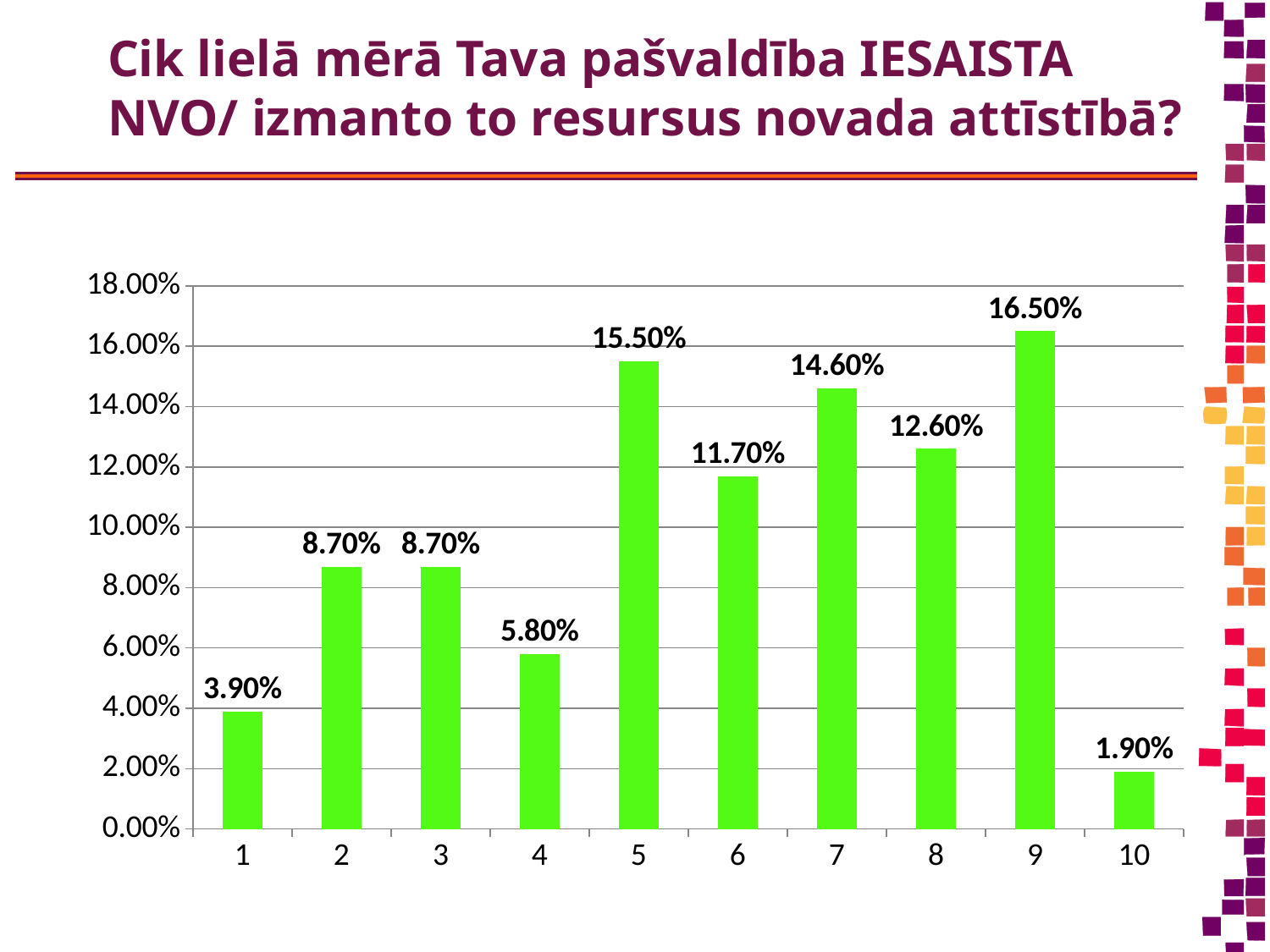
What colour are the bars in the chart? green How many categories are shown on the x axis? 10 What kind of chart is shown on the slide? bar chart Which is larger, the value for category 6 or the value for category 8? 8 Do the values rise or fall from category 9 to category 10? fall Which category has the highest value? 9 Is the value for category 4 greater or less than 6.00%? less What is the difference between the values for category 9 and category 7? 1.90% What is the value for category 8? 12.60% What is the value for category 10? 1.90% Which category has the lowest value? 10 What is the value for category 5? 15.50%